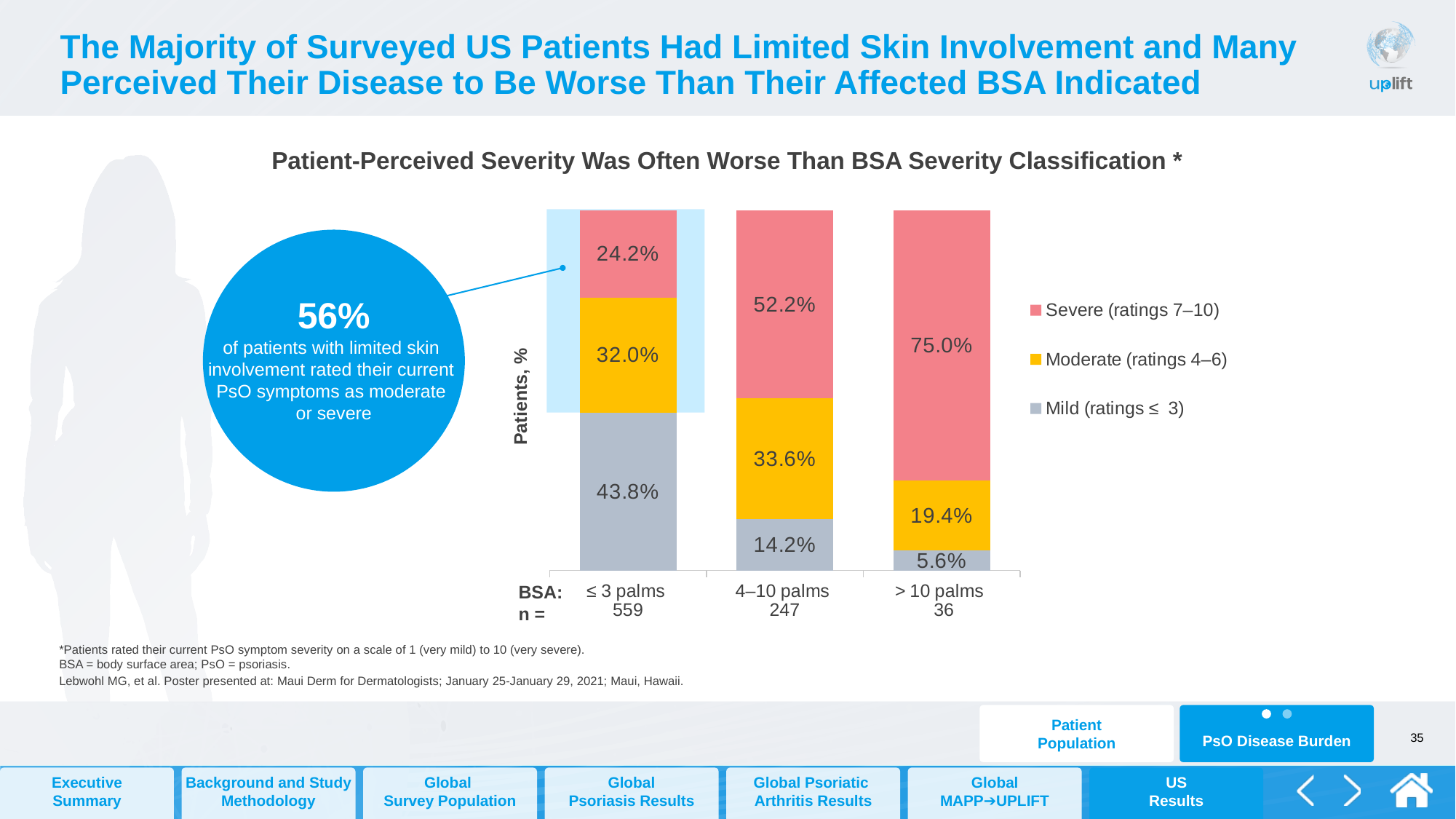
What percentage of patients with BSA 4–10 palms rated their symptoms as Moderate (ratings 4–6)? 33.6% Which BSA group has the highest percentage of patients rating their symptoms as Severe? > 10 palms What is the difference between the Severe percentage for the 4–10 palms group and the ≤ 3 palms group? 28.0% What is the combined percentage of Moderate and Severe ratings in the ≤ 3 palms group? 56.2% What is the sample size (n) for the 4–10 palms BSA group? 247 Which BSA group has the lowest percentage of patients rating their symptoms as Mild? > 10 palms How many BSA categories are shown on the x axis of the chart? 3 How many series does the chart legend list? 3 Is the Moderate percentage larger for the ≤ 3 palms group or the > 10 palms group? ≤ 3 palms What percentage of patients with BSA ≤ 3 palms rated their symptoms as Mild (ratings ≤ 3)? 43.8% What type of chart is used to show patient-perceived severity by BSA group? Stacked bar chart What percentage of patients with BSA > 10 palms rated their symptoms as Severe (ratings 7–10)? 75.0%